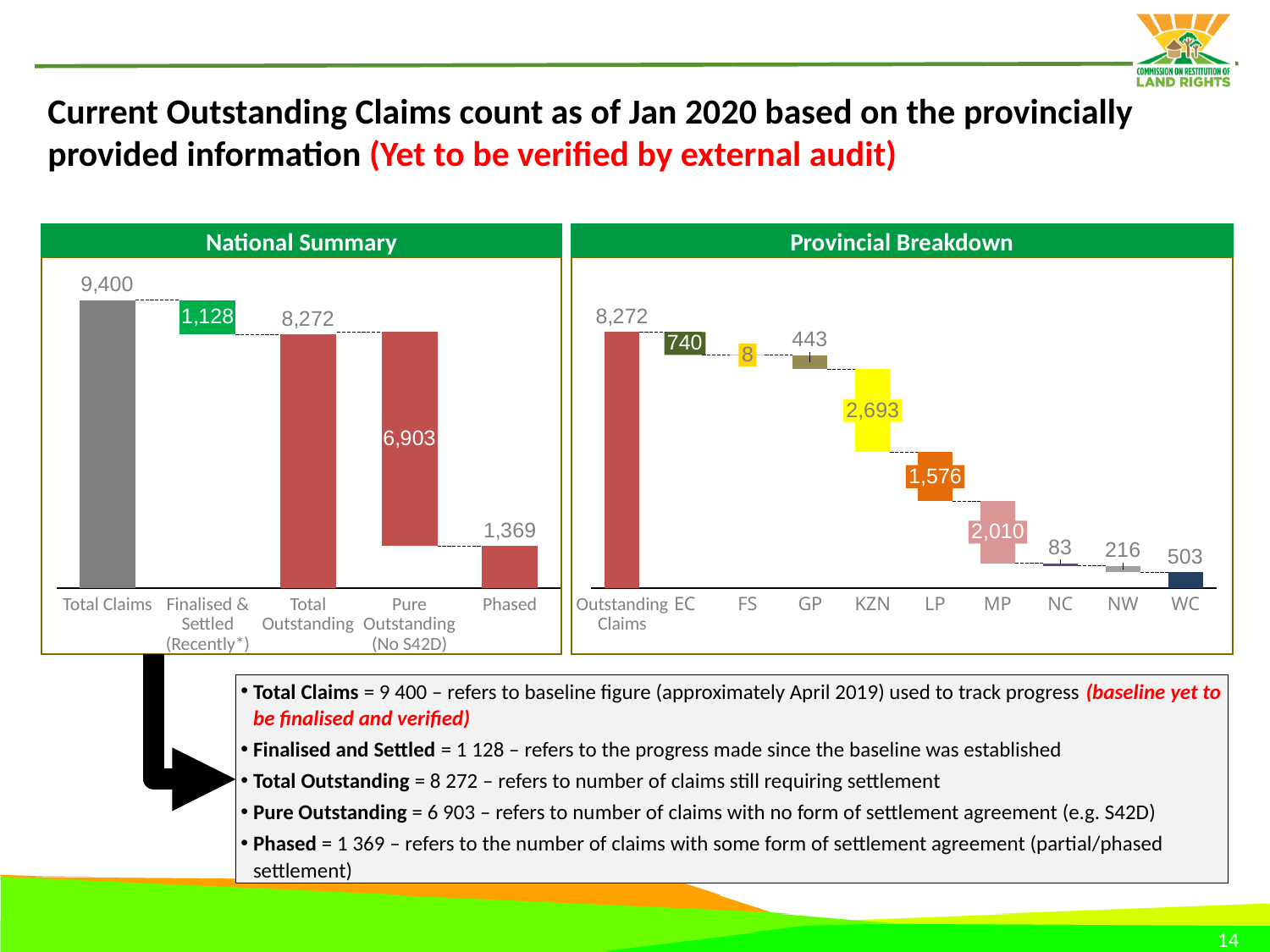
In the Provincial Breakdown chart, what is the difference between the values for MP and LP? 434 In the Provincial Breakdown chart, which province has the lowest value? FS In the National Summary chart, what is the value for Total Claims? 9,400 In the National Summary chart, what is the difference between Total Claims and Total Outstanding? 1,128 What type of chart is the National Summary chart? Bar chart (waterfall) In the National Summary chart, what is the value for Phased? 1,369 In the Provincial Breakdown chart, which province has the highest value? KZN In the Provincial Breakdown chart, what is the value for FS? 8 In the Provincial Breakdown chart, which is larger, the value for LP or the value for MP? MP In the Provincial Breakdown chart, what is the value for KZN? 2,693 In the National Summary chart, what is the value for Pure Outstanding (No S42D)? 6,903 How many provinces are shown in the Provincial Breakdown chart? 9